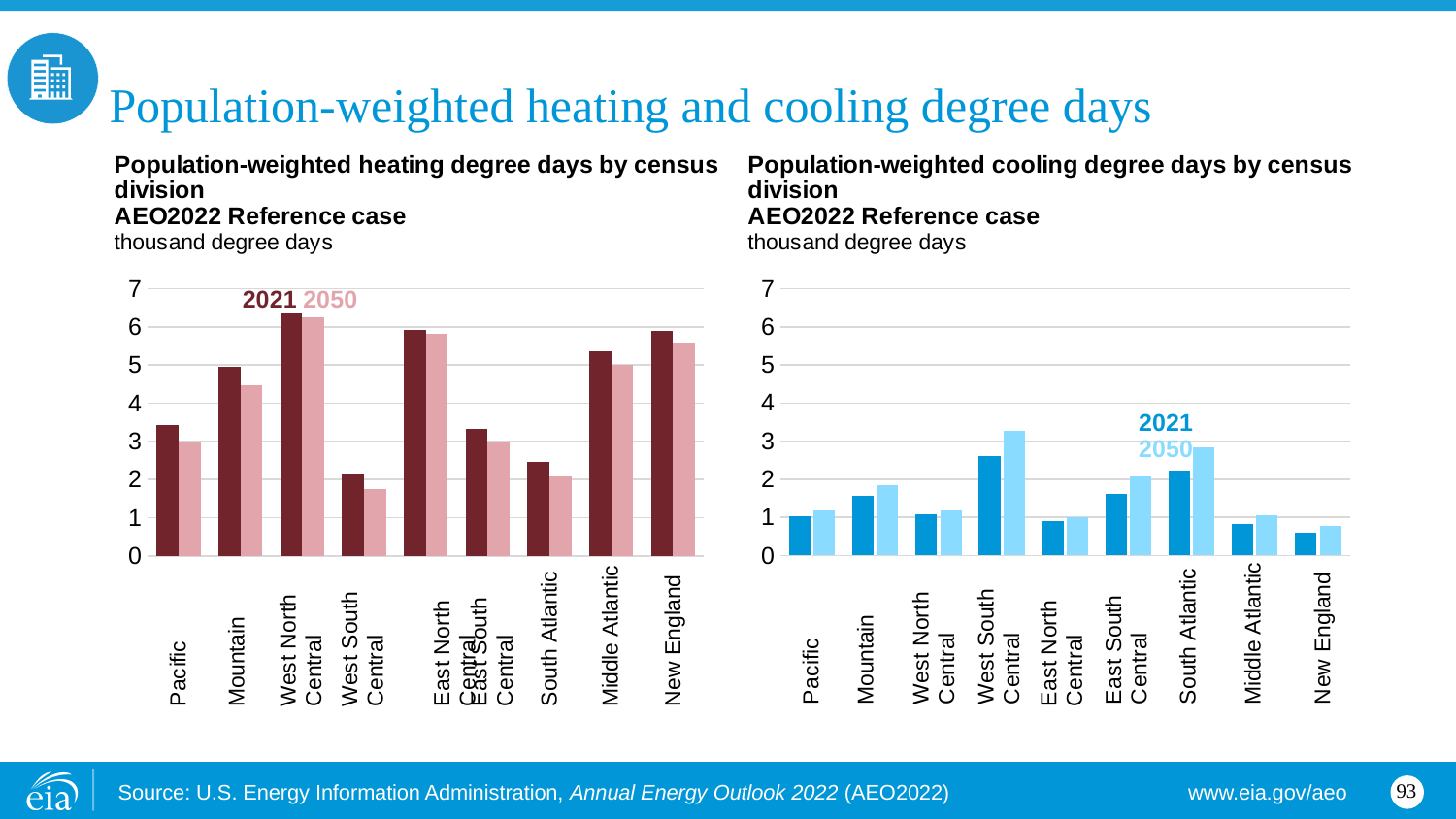
How many series does the cooling degree days chart show? 2 How many census divisions are shown on the x axis of the heating degree days chart? 9 In the heating degree days chart, which census division has the highest 2021 value? West North Central In the heating degree days chart, is the 2021 value for West North Central greater or less than 6? greater In the cooling degree days chart, are the 2050 values higher or lower than the 2021 values across the census divisions? higher In the heating degree days chart, which census division has the lowest 2021 value? West South Central In the cooling degree days chart, which census division has the highest 2050 value? West South Central In the cooling degree days chart, which census division has the lowest 2021 value? New England In the cooling degree days chart, is the 2050 value for West South Central greater or less than 3? greater What kind of chart is the population-weighted heating degree days chart on the left? bar chart In the heating degree days chart, which is larger for Mountain: the 2021 value or the 2050 value? 2021